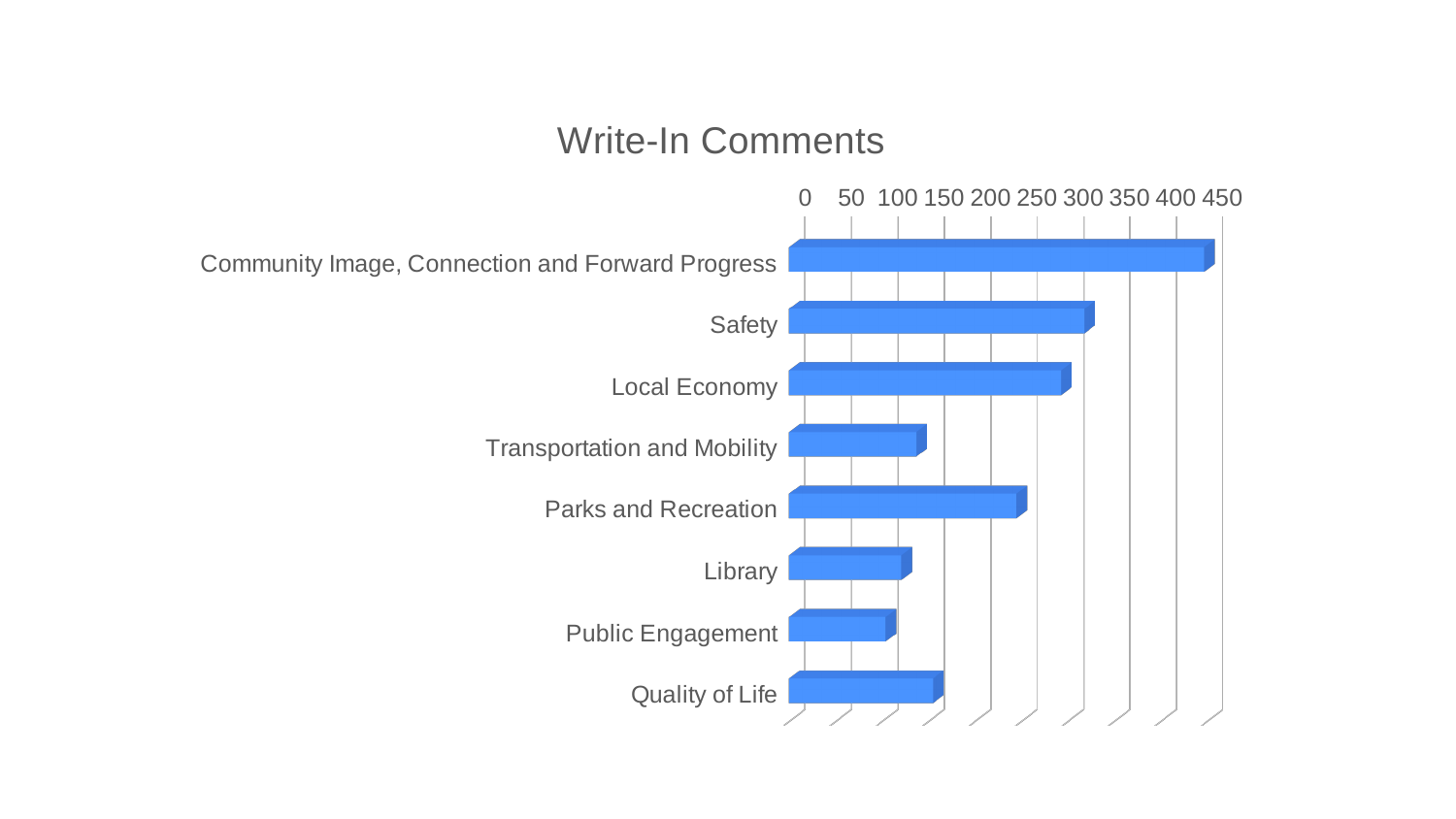
Is the value for Quality of Life greater or less than 200? less What kind of chart is shown on the slide? bar chart How many categories are shown in the chart? 8 Is the value for Library greater or less than 150? less Is the value for Safety greater or less than 250? greater Which category has the highest value? Community Image, Connection and Forward Progress What is the title of the chart? Write-In Comments Which is larger, the value for Parks and Recreation or the value for Transportation and Mobility? Parks and Recreation Which is larger, the value for Safety or the value for Parks and Recreation? Safety